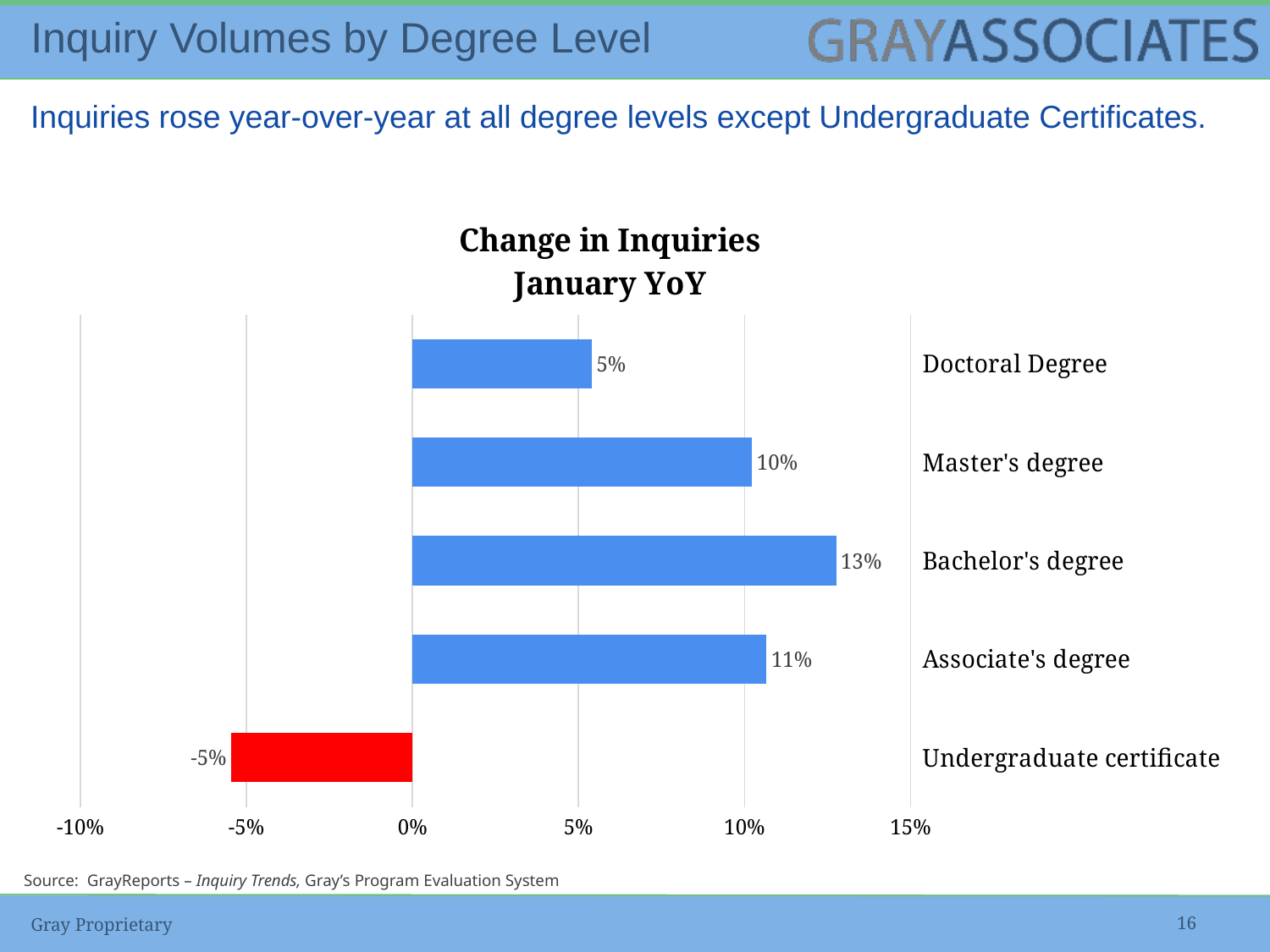
What is the change in inquiries for Master's degree? 10% Which has a larger change in inquiries, Associate's degree or Master's degree? Associate's degree What is the title of the chart? Change in Inquiries January YoY What is the change in inquiries for Undergraduate certificate? -5% What is the change in inquiries for Bachelor's degree? 13% What kind of chart is shown on the slide? Bar chart What is the difference between the change in inquiries for Bachelor's degree and Doctoral Degree? 8% Is the value for Associate's degree greater or less than 10%? greater What is the change in inquiries for Doctoral Degree? 5% How many degree levels are shown in the chart? 5 Which degree level has the lowest change in inquiries? Undergraduate certificate Which degree level has the highest change in inquiries? Bachelor's degree